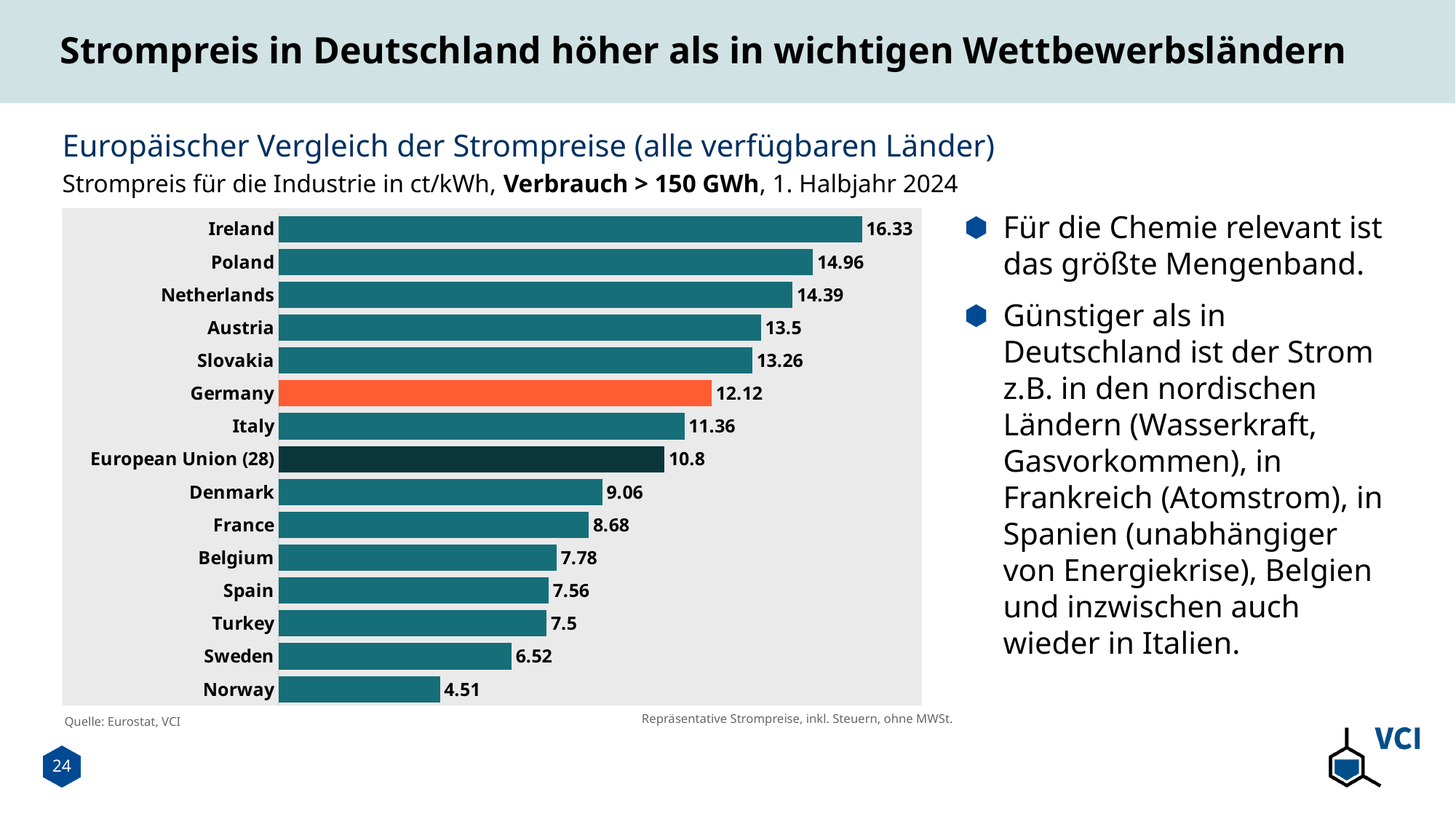
What is the value shown for France? 8.68 Which country has the lowest electricity price in the chart? Norway How many countries or regions are shown in the chart? 15 What is the electricity price shown for Germany? 12.12 Which has a higher value, Denmark or Belgium? Denmark What is the difference between the values for Ireland and Norway? 11.82 What type of chart is shown on the slide? Bar chart What is the value shown for European Union (28)? 10.8 Which has a higher value, Poland or Netherlands? Poland Which country has the highest electricity price in the chart? Ireland Which bar in the chart is highlighted in orange? Germany What is the difference between the values for Germany and European Union (28)? 1.32